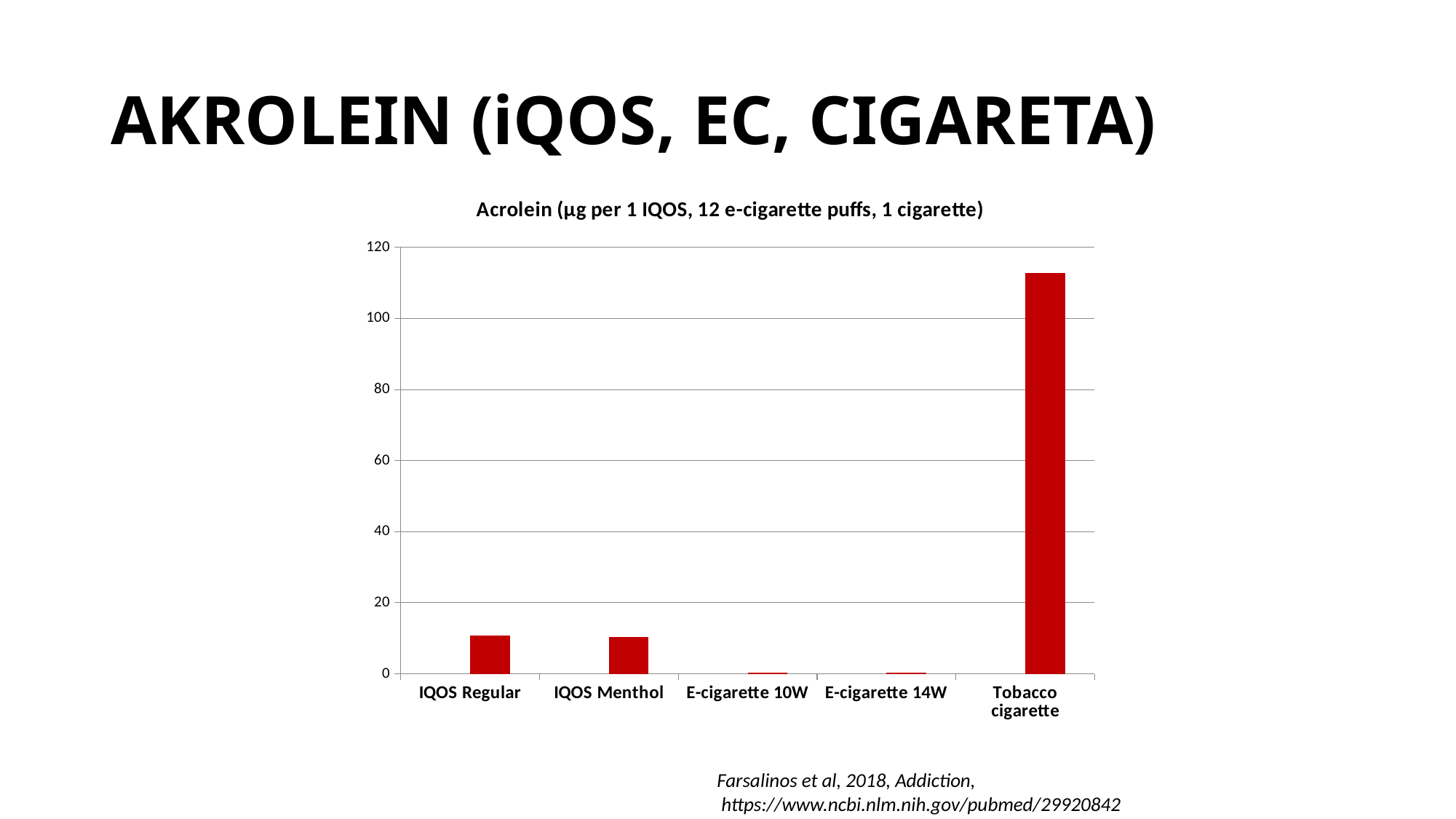
Which is larger, the value for IQOS Regular or the value for E-cigarette 14W? IQOS Regular Is the value for IQOS Regular greater or less than 20? less What kind of chart is shown on the slide? bar chart How many categories are shown on the x axis of the chart? 5 Is the value for E-cigarette 10W greater or less than 20? less What is the title of the chart? Acrolein (μg per 1 IQOS, 12 e-cigarette puffs, 1 cigarette) Which is larger, the value for Tobacco cigarette or the value for IQOS Regular? Tobacco cigarette What is the highest value shown on the y axis of the chart? 120 Is the value for Tobacco cigarette greater or less than 80? greater Which category has the highest acrolein value? Tobacco cigarette